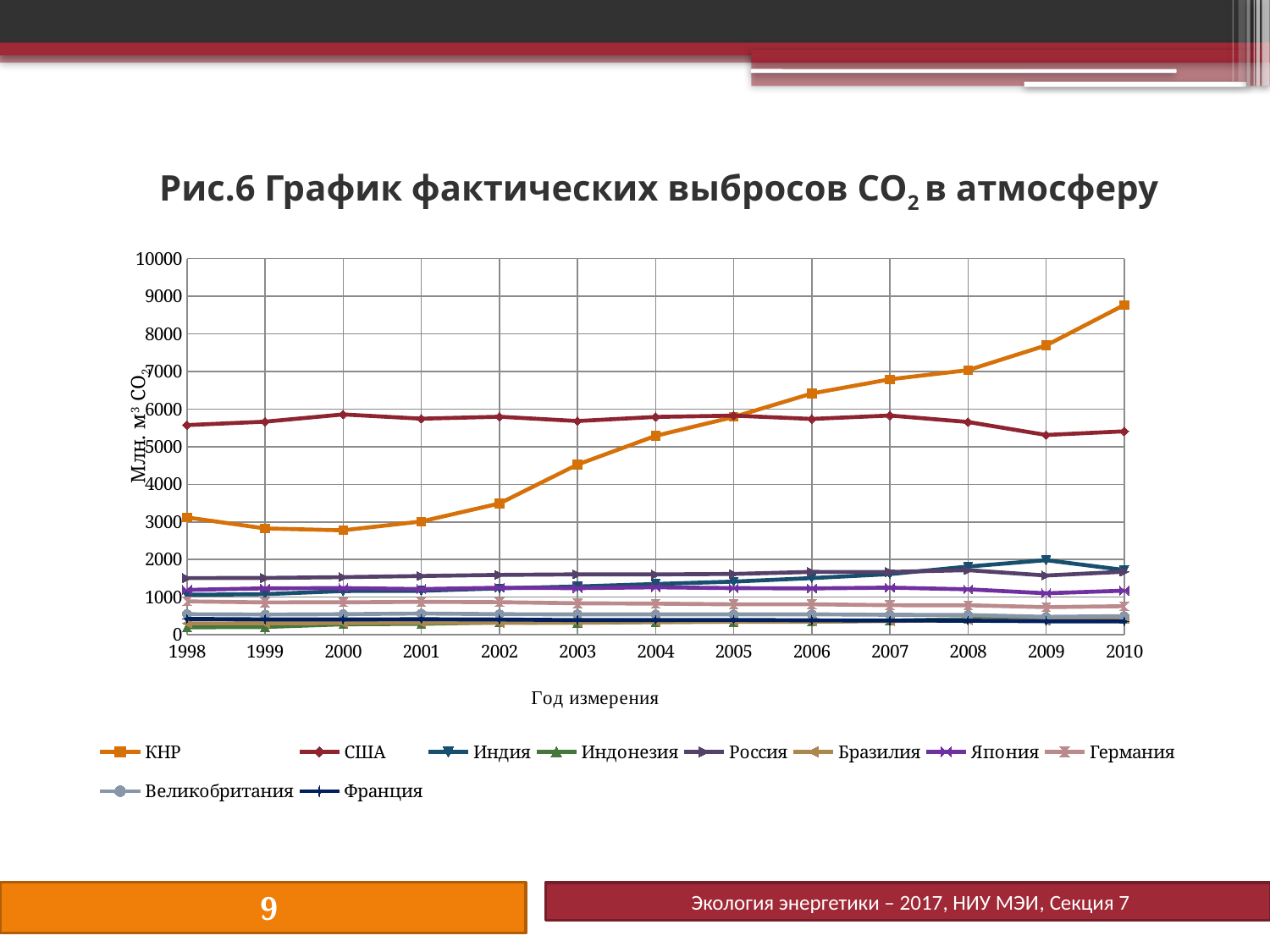
In 1998, which is larger: the value for США or the value for КНР? США Which series has the highest value in 2010? КНР Is the value for США in 1998 greater or less than 5000? greater How many series does the legend list? 10 Is the value for КНР in 2000 greater or less than 3000? less Is the value for КНР in 2010 greater or less than 8000? greater How many years are plotted along the x axis? 13 Do the values for КНР rise or fall from 2001 to 2010? rise What is the title of the x axis? Год измерения What kind of chart is shown on the slide? line chart In 2010, which is larger: the value for КНР or the value for США? КНР